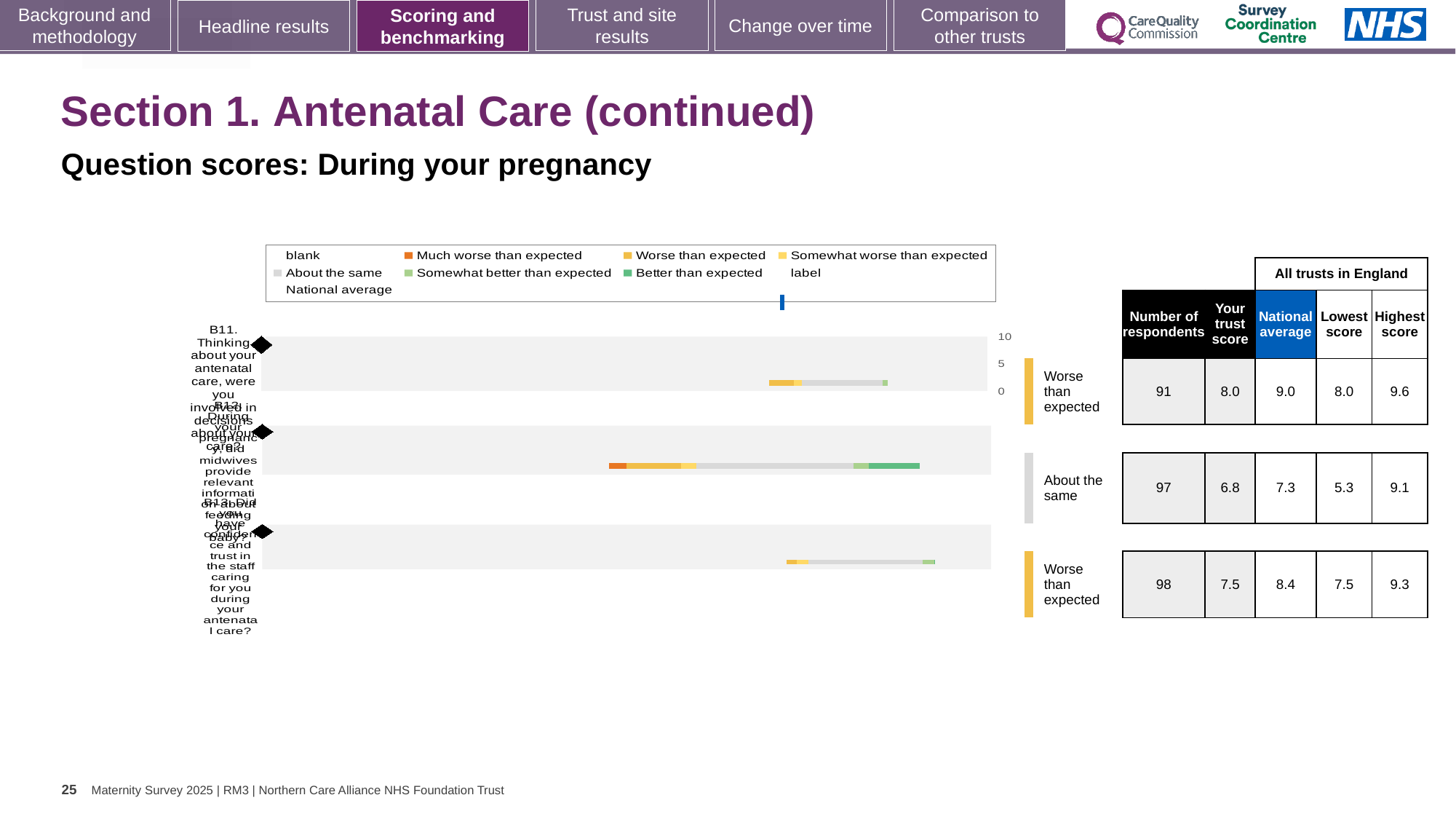
What is the trust score for question B11 (involved in decisions about your care)? 8.0 What is the highest score among all trusts in England for question B13 (confidence and trust in staff)? 9.3 Which question has the lowest trust score? B12 How many questions (bars) are plotted in the chart? 3 Which benchmark category is question B12 placed in? About the same Which question has the highest number of respondents? B13 What is the chart's subtitle describing the question scores? Question scores: During your pregnancy What is the difference between the national average and the trust score for question B12? 0.5 Which colour does the legend use for 'Much worse than expected'? orange What kind of chart is shown on the slide? bar chart How many respondents answered question B12 (midwives provide relevant information about feeding your baby)? 97 Is the trust score for B11 higher or lower than the trust score for B13? B11 is higher